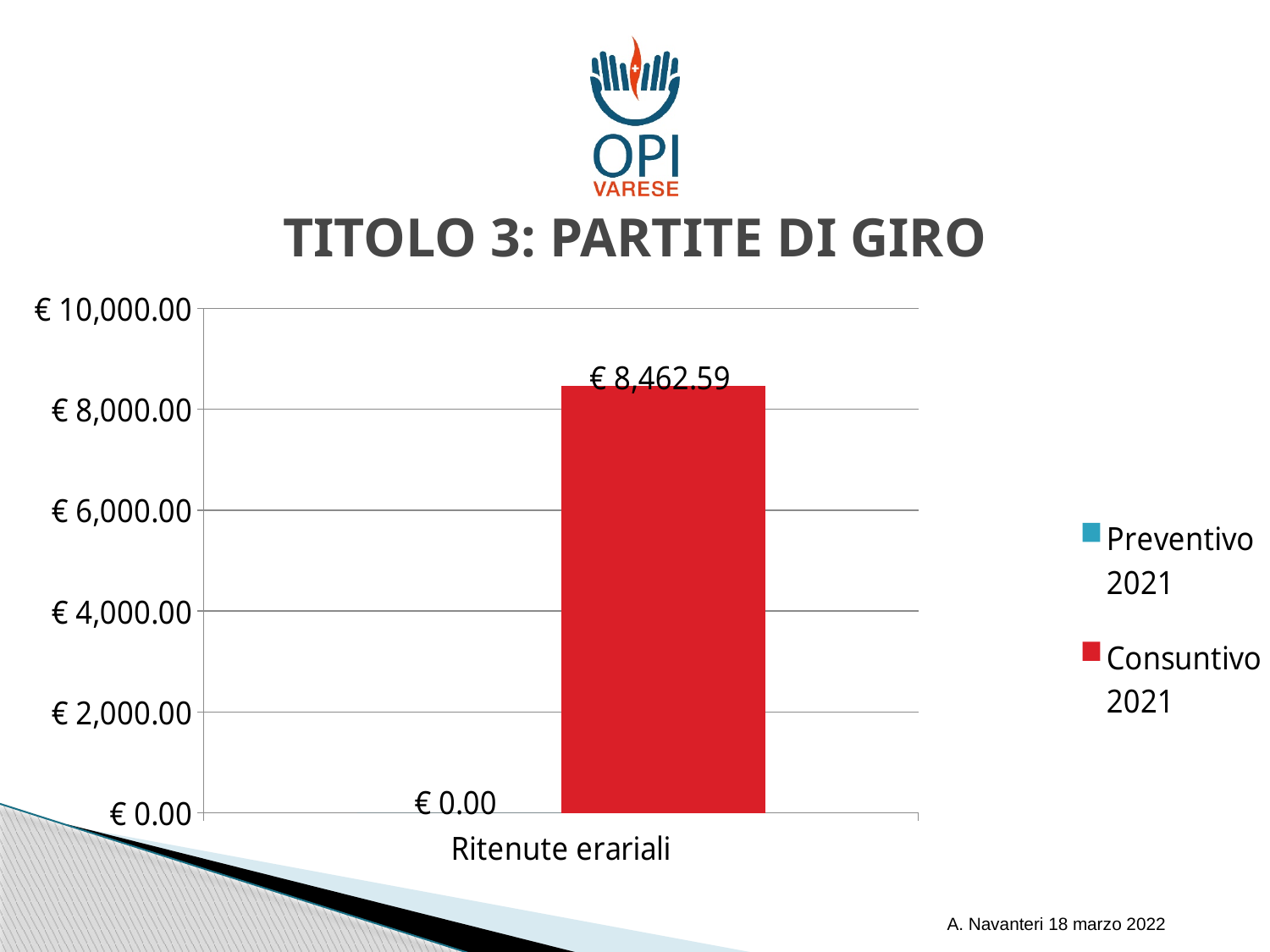
What colour is the Consuntivo 2021 series in the chart? Red Is the Consuntivo 2021 value for Ritenute erariali greater or less than € 10,000.00? less What kind of chart is shown on the slide? Bar chart What is the value of Consuntivo 2021 for Ritenute erariali? € 8,462.59 What is the category label shown on the x axis? Ritenute erariali Is the Consuntivo 2021 value for Ritenute erariali greater or less than € 8,000.00? greater How many series does the legend list? 2 What is the title of the slide above the chart? TITOLO 3: PARTITE DI GIRO Which series has the higher value for Ritenute erariali, Preventivo 2021 or Consuntivo 2021? Consuntivo 2021 What is the difference between Consuntivo 2021 and Preventivo 2021 for Ritenute erariali? € 8,462.59 How many categories are shown on the x axis of the chart? 1 What is the value of Preventivo 2021 for Ritenute erariali? € 0.00